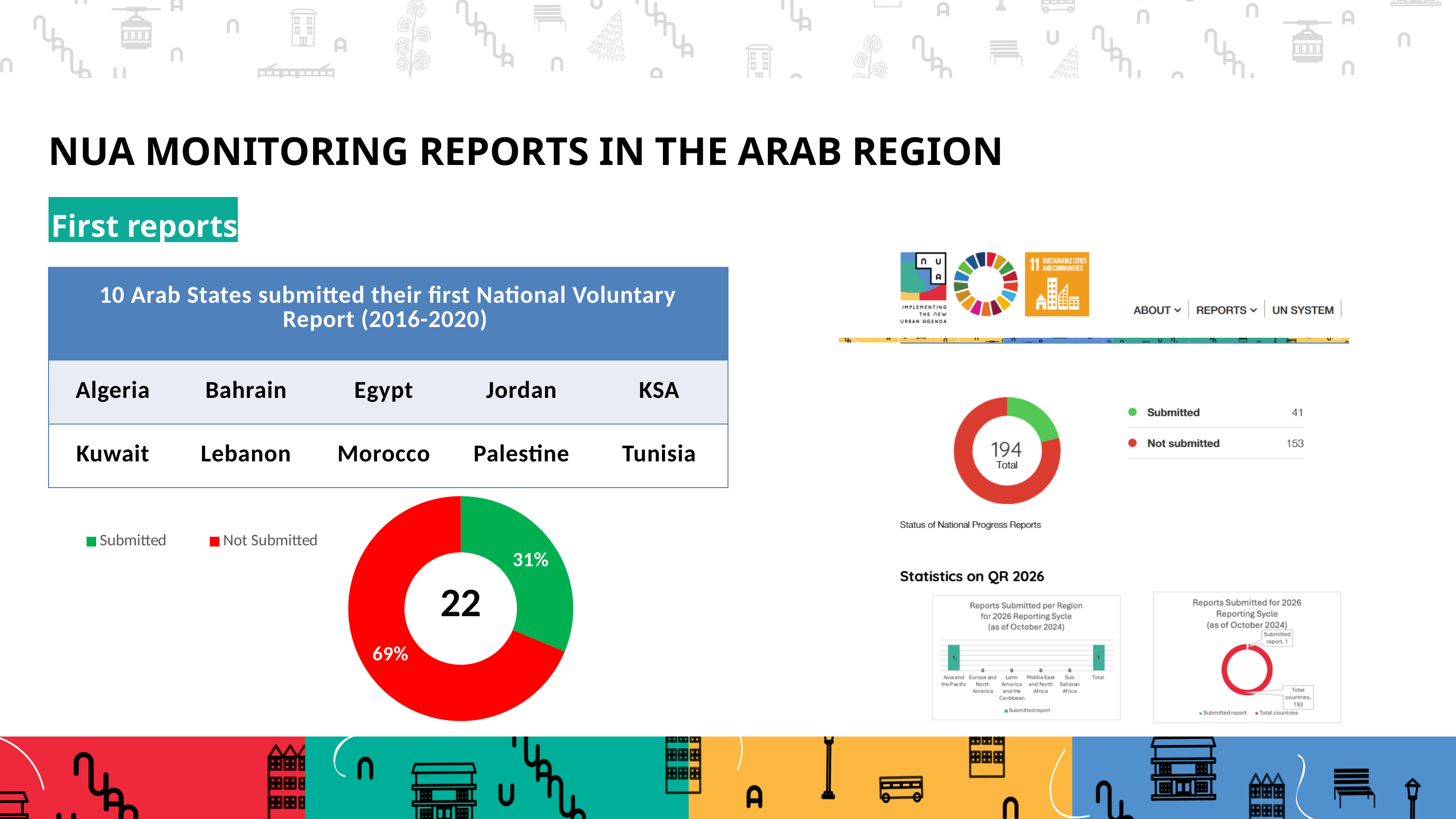
In the 'Status of National Progress Reports' donut chart on the right, what is the difference between Not submitted and Submitted? 112 In the bottom-left donut chart with 22 in the centre, what is the difference in percentage points between Not Submitted and Submitted? 38 In the bottom-left donut chart with 22 in the centre, which category has the larger share, Submitted or Not Submitted? Not Submitted How many entries does the legend of the bottom-left donut chart with 22 in the centre list? 2 In the 'Status of National Progress Reports' donut chart on the right, what is the value for Submitted? 41 In the bottom-left donut chart with 22 in the centre, what colour is the Submitted slice? green In the bottom-left donut chart with 22 in the centre, what percentage is shown for Not Submitted? 69% What type of chart is the chart at the bottom left of the slide with the number 22 in the centre? donut chart In the 'Status of National Progress Reports' donut chart on the right, what is the value for Not submitted? 153 In the bottom-left donut chart with 22 in the centre, what percentage is shown for Submitted? 31% In the 'Status of National Progress Reports' donut chart on the right, what total is shown in the centre? 194 In the 'Reports Submitted per Region for 2026 Reporting Cycle' bar chart on the right, what is the value for Asia and the Pacific? 1